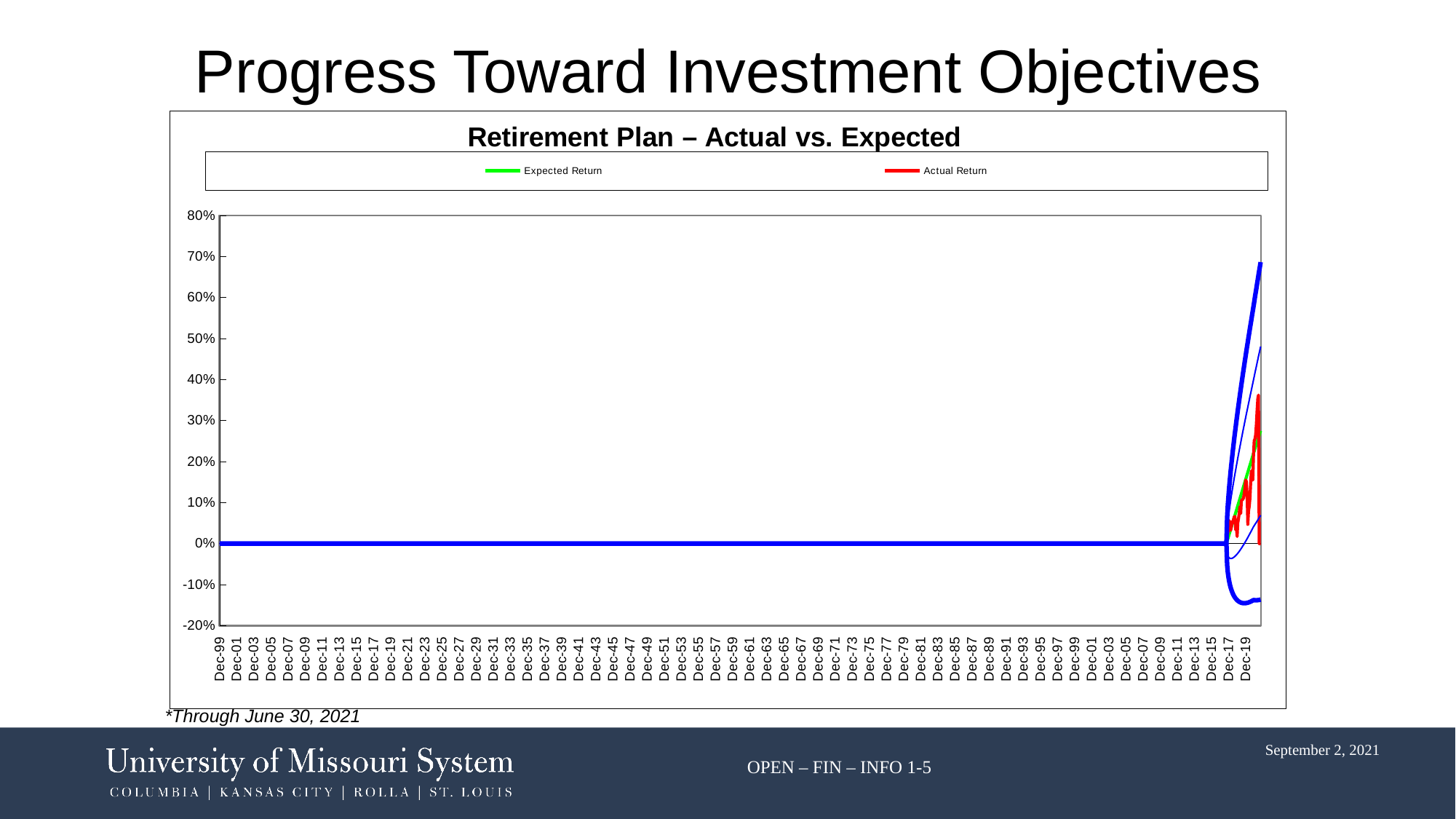
What kind of chart is shown on the slide? Line chart Which colour represents the Expected Return series in the legend? Green What is the title of the chart? Retirement Plan – Actual vs. Expected Is the peak of the Actual Return line greater or less than 40%? less Is the peak of the Actual Return line greater or less than 30%? greater What is the first label on the horizontal axis? Dec-99 How many series does the chart legend list? 2